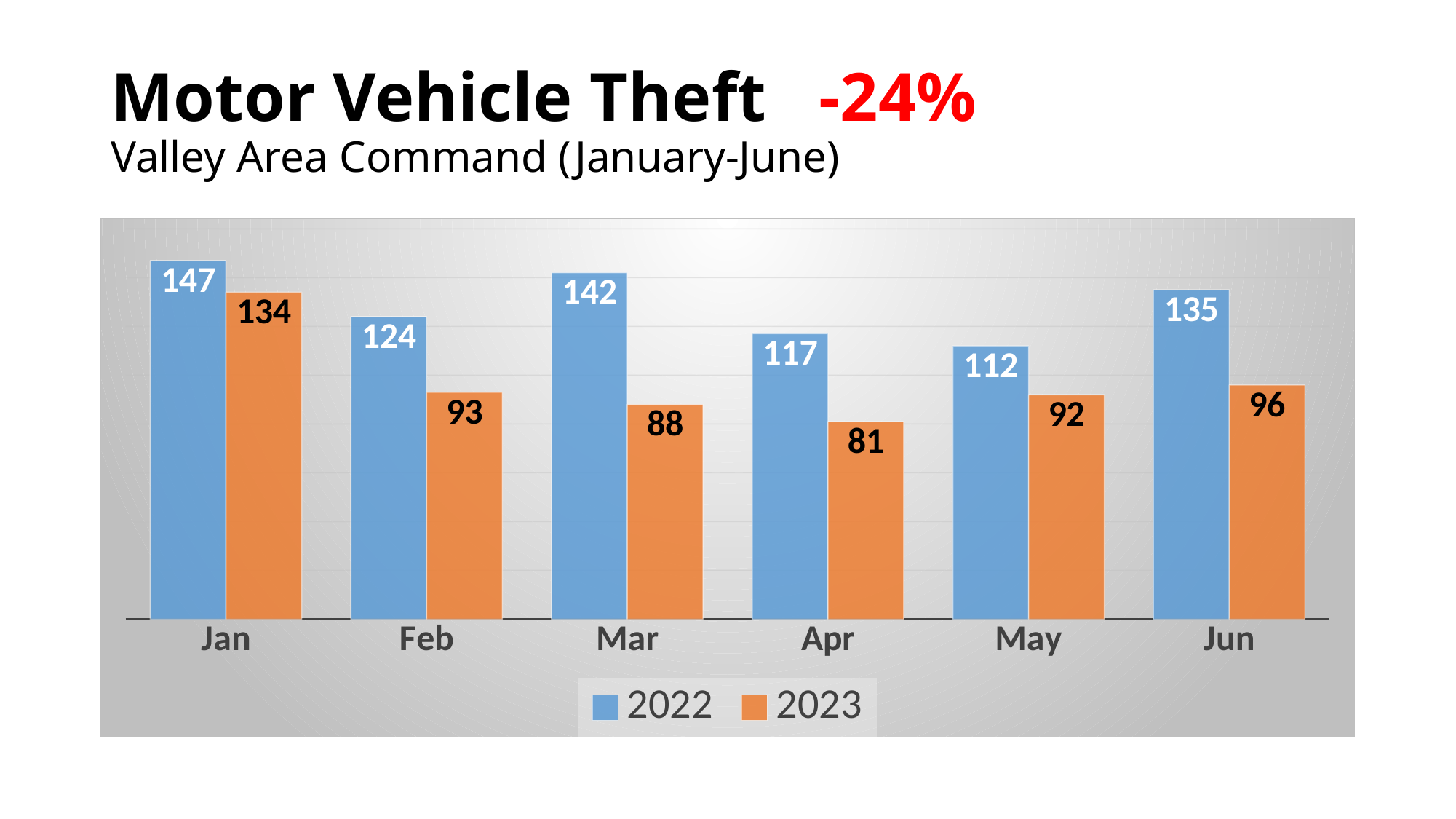
Which colour represents the 2023 series in the legend? Orange What percentage change is shown next to the title? -24% What was the motor vehicle theft count for 2023 in June? 96 How many series does the legend list? 2 Which is larger, the 2023 value for February or the 2023 value for May? 2023 value for May Which month had the lowest 2023 value? Apr What was the motor vehicle theft count for 2023 in April? 81 Which month had the highest 2022 value? Jan How many months are shown on the x axis? 6 What kind of chart is shown on the slide? Bar chart What was the motor vehicle theft count for 2022 in January? 147 What is the difference between the 2022 and 2023 values in March? 54